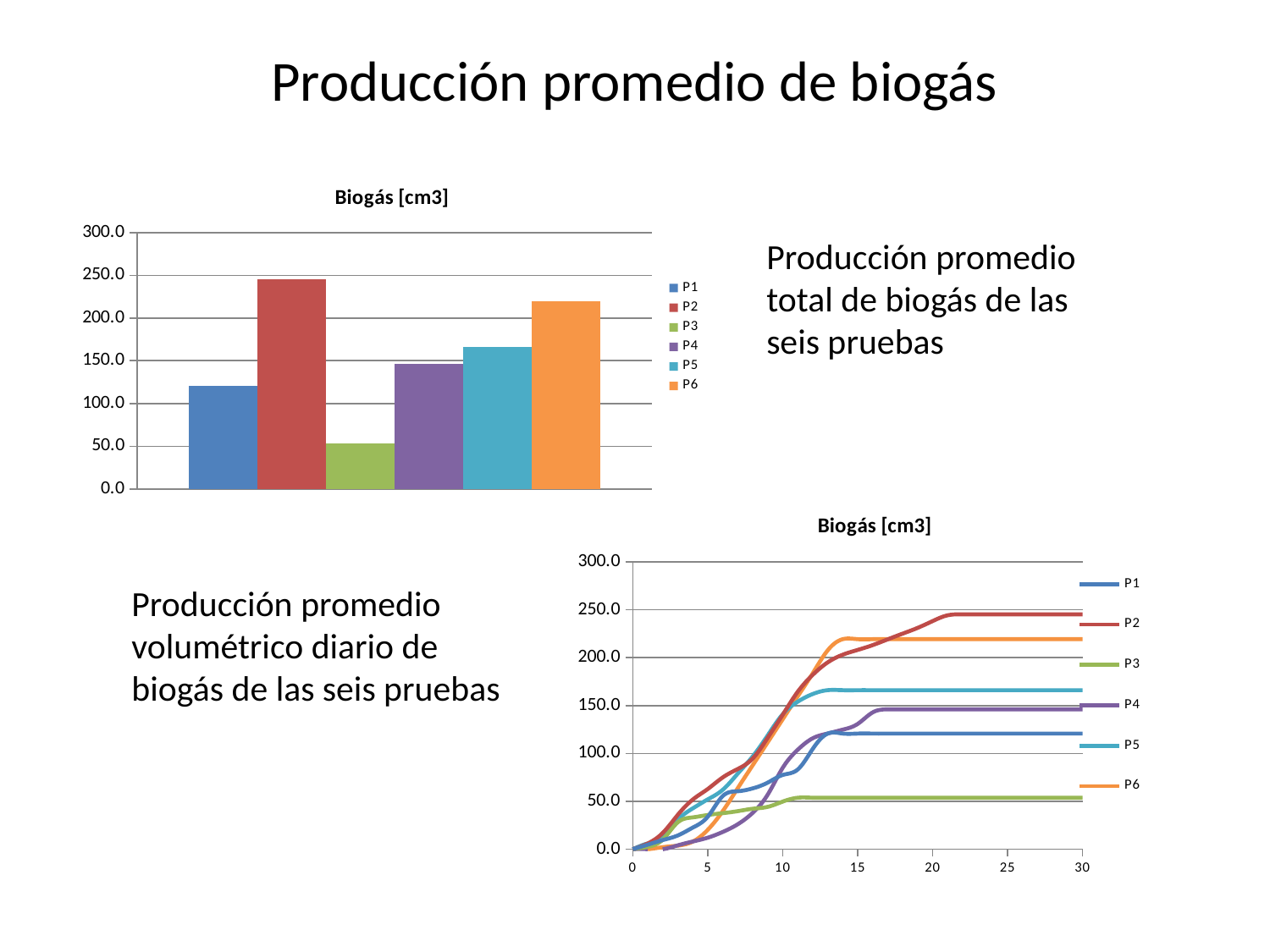
In the bottom-right line chart, which series has the highest value at x = 30? P2 In the top-left bar chart, which category has the highest value? P2 In the bottom-right line chart, how do the values of the series change along the x axis? They rise and then level off In the top-left bar chart, which category has the lowest value? P3 In the top-left bar chart, is the value for P6 greater or less than 200.0? greater In the top-left bar chart, how many series does the legend list? 6 What kind of chart is the bottom-right chart on the slide? line chart In the top-left bar chart, is the value for P3 greater or less than 100.0? less In the top-left bar chart, is the value for P1 greater or less than 100.0? greater In the top-left bar chart, which is larger, the value for P5 or the value for P4? P5 What kind of chart is the top-left chart on the slide? bar chart In the bottom-right line chart, how many series does the legend list? 6